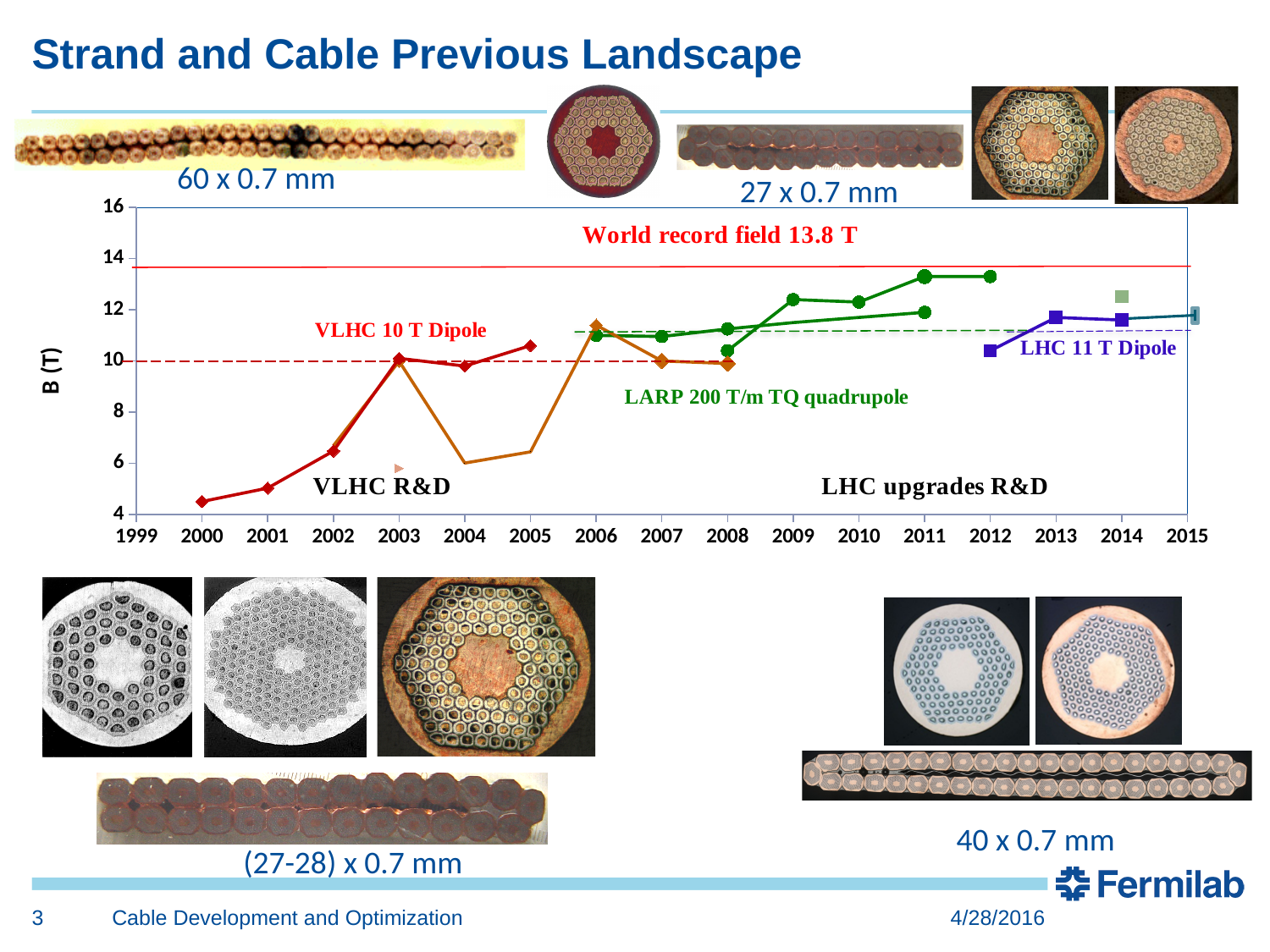
How many year labels are shown along the x axis of the chart? 17 Is the value of the blue LHC 11 T Dipole series in 2013 greater or less than 10? greater What is the lowest value shown on the vertical axis of the chart? 4 Which is larger: the red series value in 2000 or the green series value in 2011? the green series value in 2011 Is the value of the green LARP series in 2006 greater or less than 12? less What kind of chart is shown on the slide? line chart Is the value of the red VLHC series in 2000 greater or less than 6? less What world record field value is annotated on the chart? 13.8 T What is the label of the vertical axis of the chart? B (T) Which is larger: the red series value in 2002 or the blue series value in 2013? the blue series value in 2013 Does the red VLHC series rise or fall from 2000 to 2003? rise